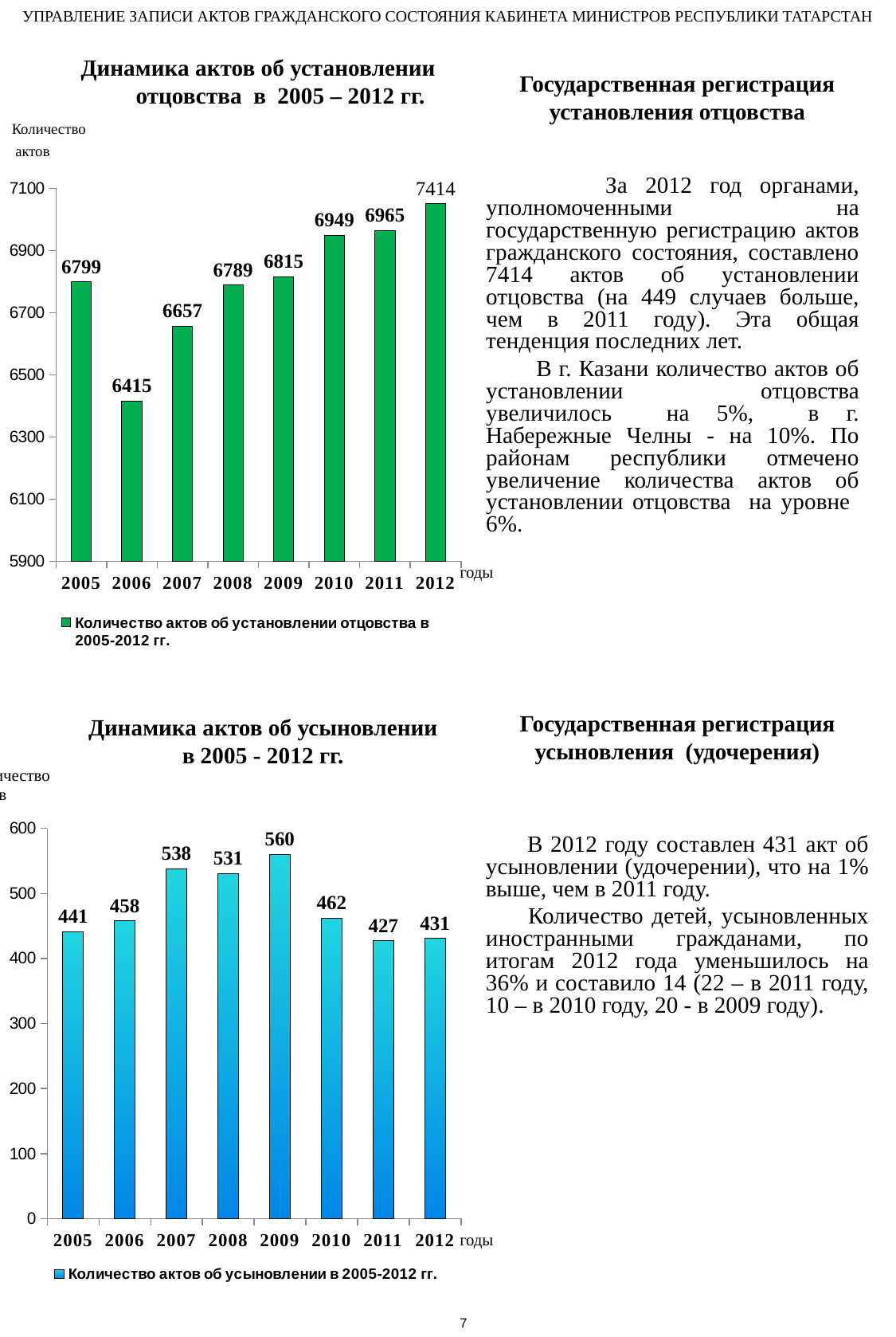
In the top chart (Динамика актов об установлении отцовства), is the value for 2010 greater or less than 6900? greater In the bottom chart (Динамика актов об усыновлении), what is the value for 2011? 427 In the bottom chart (Динамика актов об усыновлении), which year has the highest value? 2009 In the bottom chart (Динамика актов об усыновлении), what is the difference between the values for 2009 and 2005? 119 In the top chart (Динамика актов об установлении отцовства), what is the value for 2007? 6657 How many series does the legend of the top chart (Динамика актов об установлении отцовства) list? 1 In the top chart (Динамика актов об установлении отцовства), what is the value for 2012? 7414 In the top chart (Динамика актов об установлении отцовства), what is the difference between the values for 2012 and 2011? 449 In the top chart (Динамика актов об установлении отцовства), how many years are shown on the x axis? 8 In the top chart (Динамика актов об установлении отцовства), which year has the lowest value? 2006 What kind of chart is the bottom chart (Динамика актов об усыновлении)? bar chart In the bottom chart (Динамика актов об усыновлении), which is larger, the value for 2007 or the value for 2008? 2007